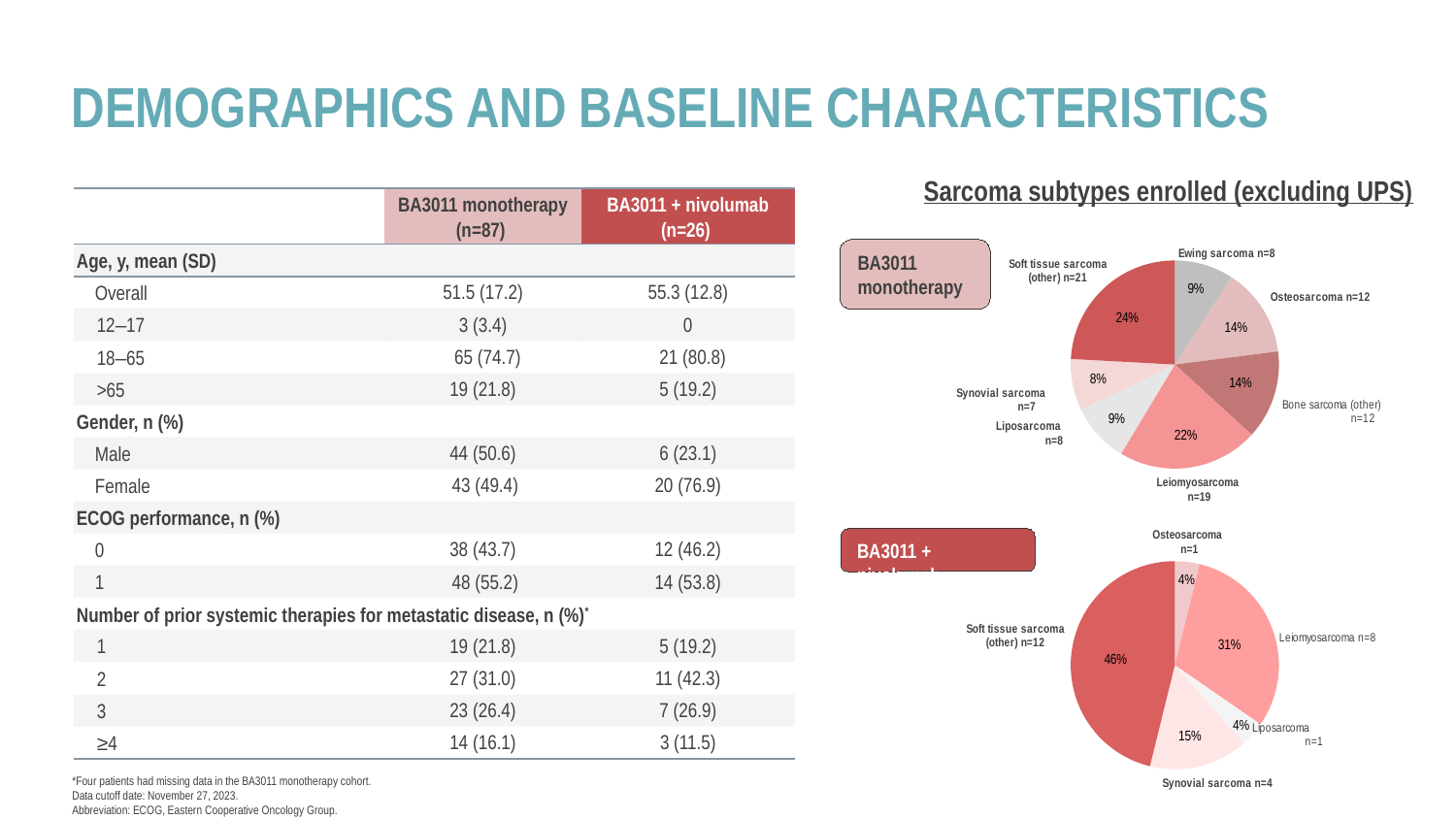
In the BA3011 + nivolumab pie chart, which sarcoma subtype has the largest share? Soft tissue sarcoma (other) What type of chart is used to show the sarcoma subtypes enrolled? Pie chart In the BA3011 monotherapy pie chart, how many sarcoma subtypes are shown? 7 In the BA3011 monotherapy pie chart, which sarcoma subtype has the smallest share? Synovial sarcoma In the BA3011 monotherapy pie chart, how many patients had soft tissue sarcoma (other)? n=21 In the BA3011 + nivolumab pie chart, how many sarcoma subtypes are shown? 5 In the BA3011 + nivolumab pie chart, what percentage of patients had leiomyosarcoma? 31% In the BA3011 monotherapy pie chart, which sarcoma subtype has the largest share? Soft tissue sarcoma (other) In the BA3011 monotherapy pie chart, what percentage of patients had leiomyosarcoma? 22% In the BA3011 + nivolumab pie chart, how many patients had synovial sarcoma? n=4 In the BA3011 + nivolumab pie chart, is the share for soft tissue sarcoma (other) larger or smaller than the share for leiomyosarcoma? larger In the BA3011 monotherapy pie chart, what is the difference in patient numbers between leiomyosarcoma and Ewing sarcoma? 11